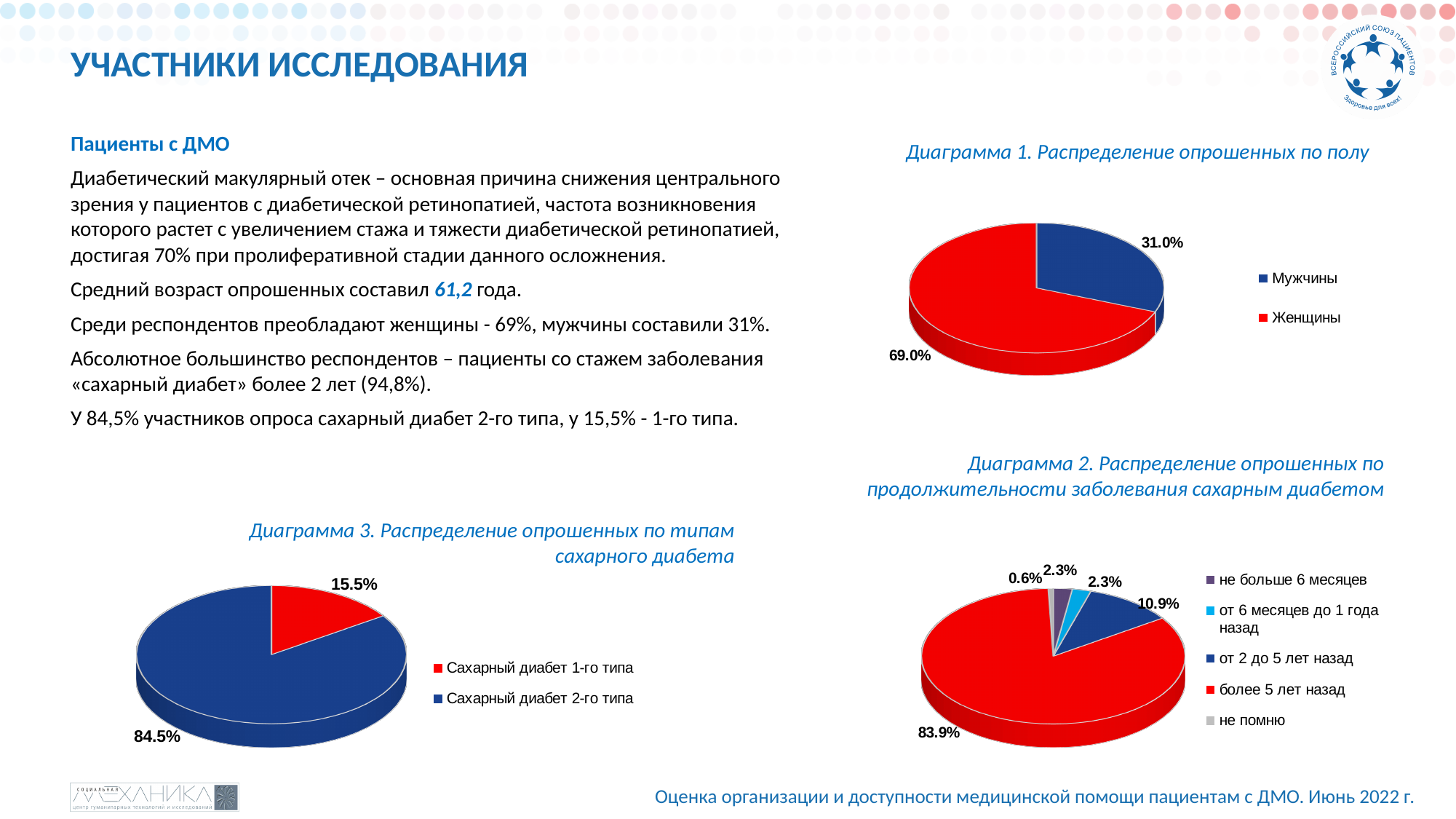
In Диаграмма 1, how many series does the legend list? 2 In Диаграмма 1, what is the difference between the shares of Женщины and Мужчины? 38.0% In Диаграмма 2, what share of respondents fall in the category 'более 5 лет назад'? 83.9% In Диаграмма 2, how many categories does the legend list? 5 In Диаграмма 2, what share of respondents fall in the category 'от 2 до 5 лет назад'? 10.9% In Диаграмма 2, which category has the largest share? более 5 лет назад In Диаграмма 3, which category has the larger share: Сахарный диабет 1-го типа or Сахарный диабет 2-го типа? Сахарный диабет 2-го типа In Диаграмма 3, what colour is the slice for Сахарный диабет 2-го типа? Blue In Диаграмма 1, what share of respondents are Мужчины? 31.0% In Диаграмма 3, what share of respondents have Сахарный диабет 1-го типа? 15.5% In Диаграмма 1, what share of respondents are Женщины? 69.0% What kind of chart is Диаграмма 2? Pie chart